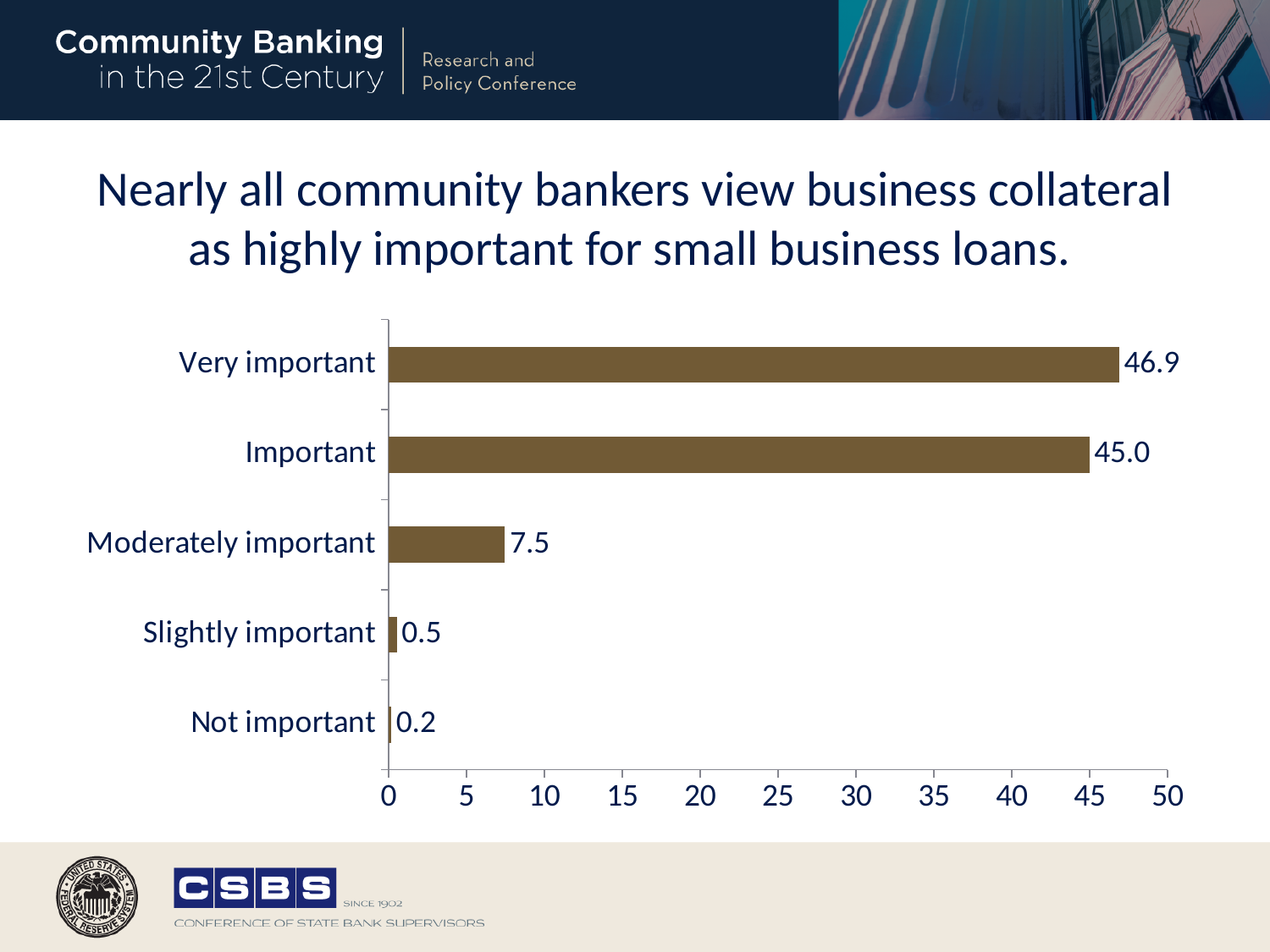
What is the value for Moderately important? 7.5 Which category has the highest value? Very important What is the value for Very important? 46.9 What is the difference between the values for Important and Moderately important? 37.5 Is the value for Important greater or less than 40? greater What is the maximum value shown on the horizontal axis? 50 How many categories are shown in the chart? 5 What kind of chart is shown on the slide? Bar chart Which is larger, the value for Moderately important or the value for Slightly important? Moderately important What is the value for Not important? 0.2 Which category has the lowest value? Not important What is the difference between the values for Very important and Important? 1.9